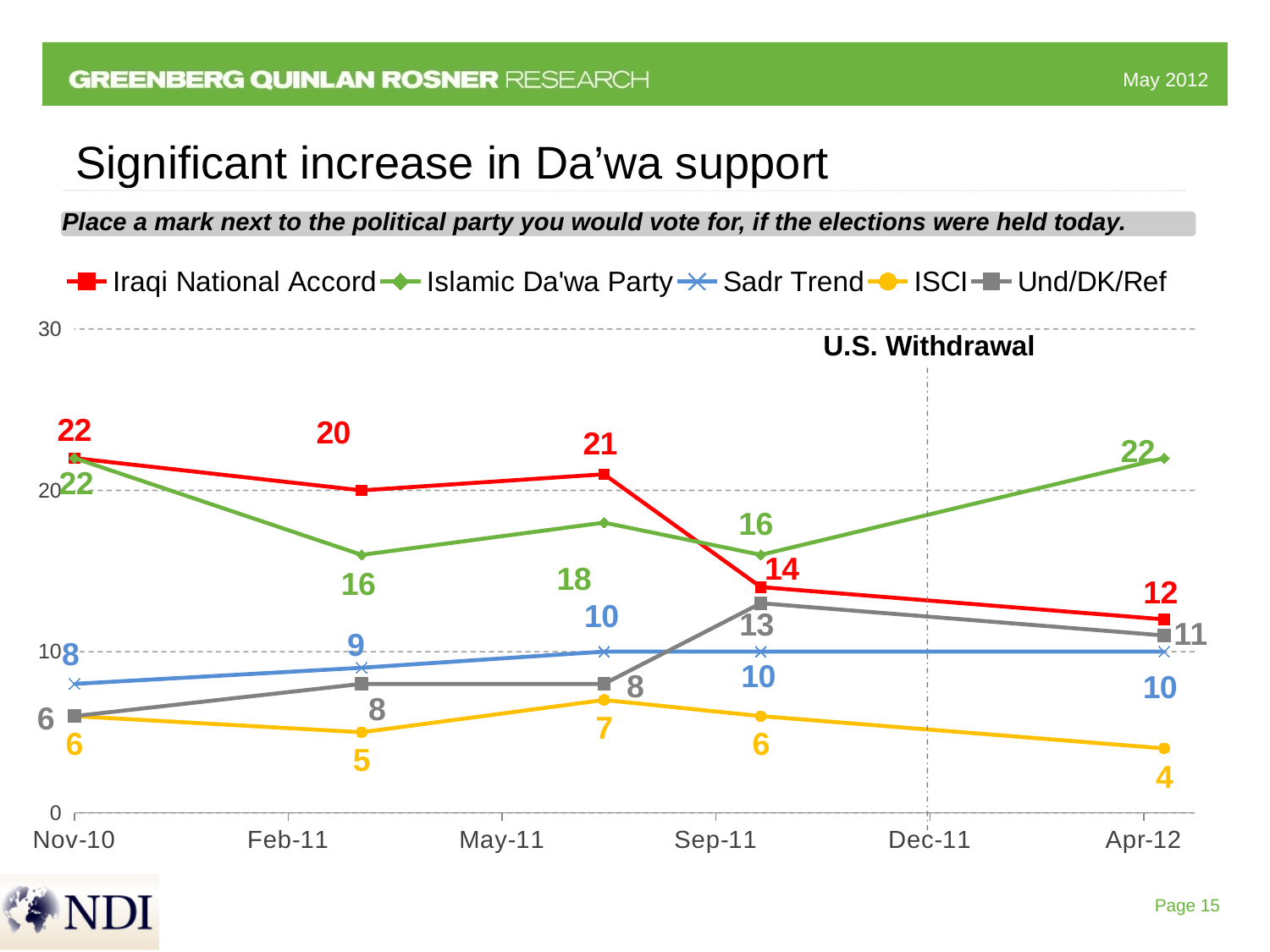
What is the value for ISCI at Apr-12? 4 What is the value for Islamic Da'wa Party at Apr-12? 22 Which series has the highest value at Apr-12? Islamic Da'wa Party At Apr-12, which is larger: Iraqi National Accord or Und/DK/Ref? Iraqi National Accord What is the value for Iraqi National Accord at Nov-10? 22 By how much did the Iraqi National Accord value fall from Nov-10 to Apr-12? 10 How many series does the legend list? 5 What is the value for Und/DK/Ref at Apr-12? 11 What is the value for Sadr Trend at Nov-10? 8 Which series has the lowest value at Apr-12? ISCI What event is marked by the vertical dashed line on the chart? U.S. Withdrawal What kind of chart is shown on the slide? Line chart